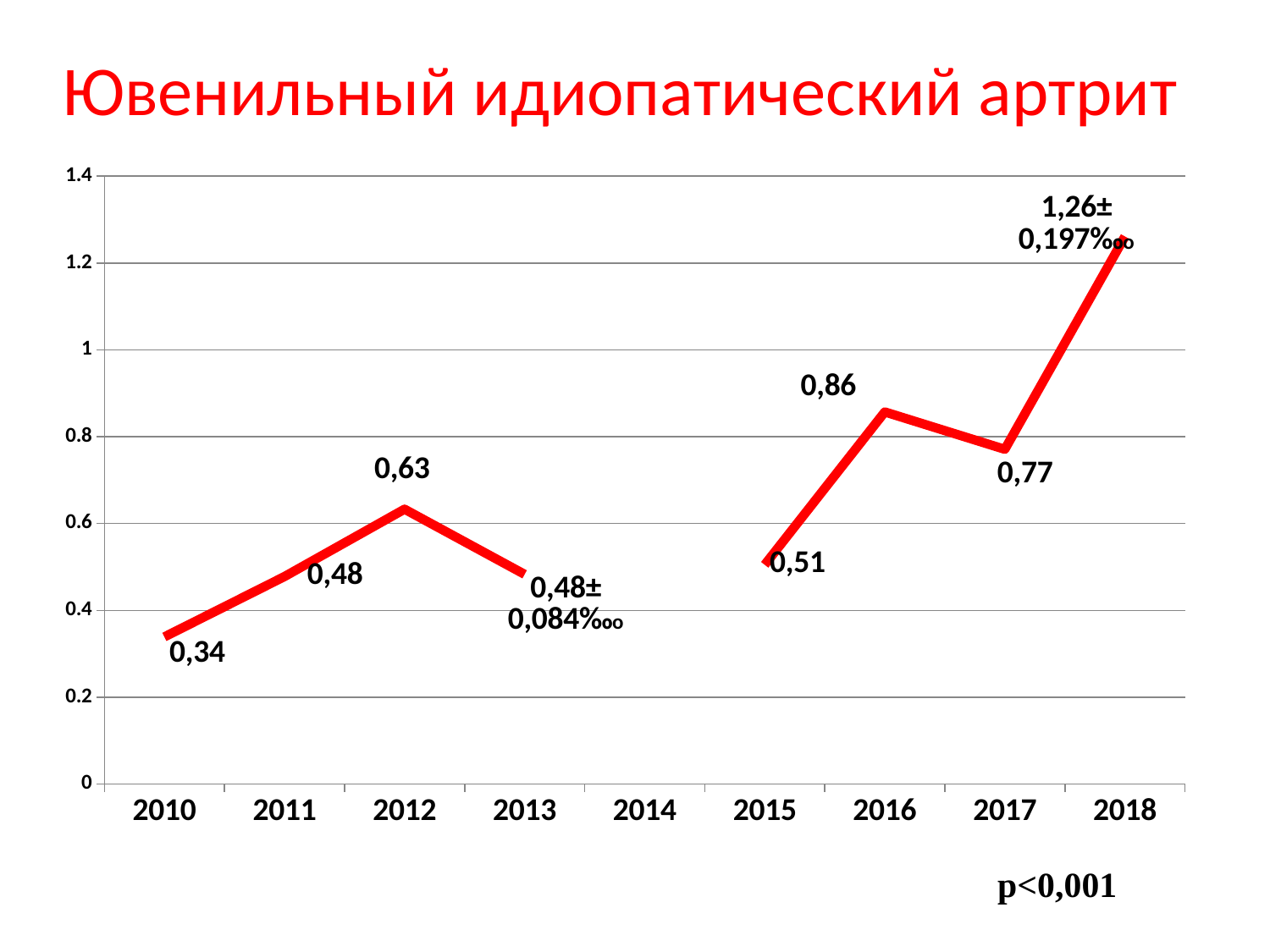
Which year has the highest value? 2018 What is the value for 2017? 0,77 Does the value rise or fall from 2017 to 2018? rise Which year has the lowest value? 2010 What is the value for 2012? 0,63 What is the data label shown for 2018? 1,26±0,197‰ What is the difference between the values for 2016 and 2017? 0,09 Which year on the x axis has no data point plotted? 2014 What is the value for 2016? 0,86 What type of chart is shown on the slide? line chart What is the value for 2010? 0,34 Which is larger, the value for 2012 or the value for 2015? 2012